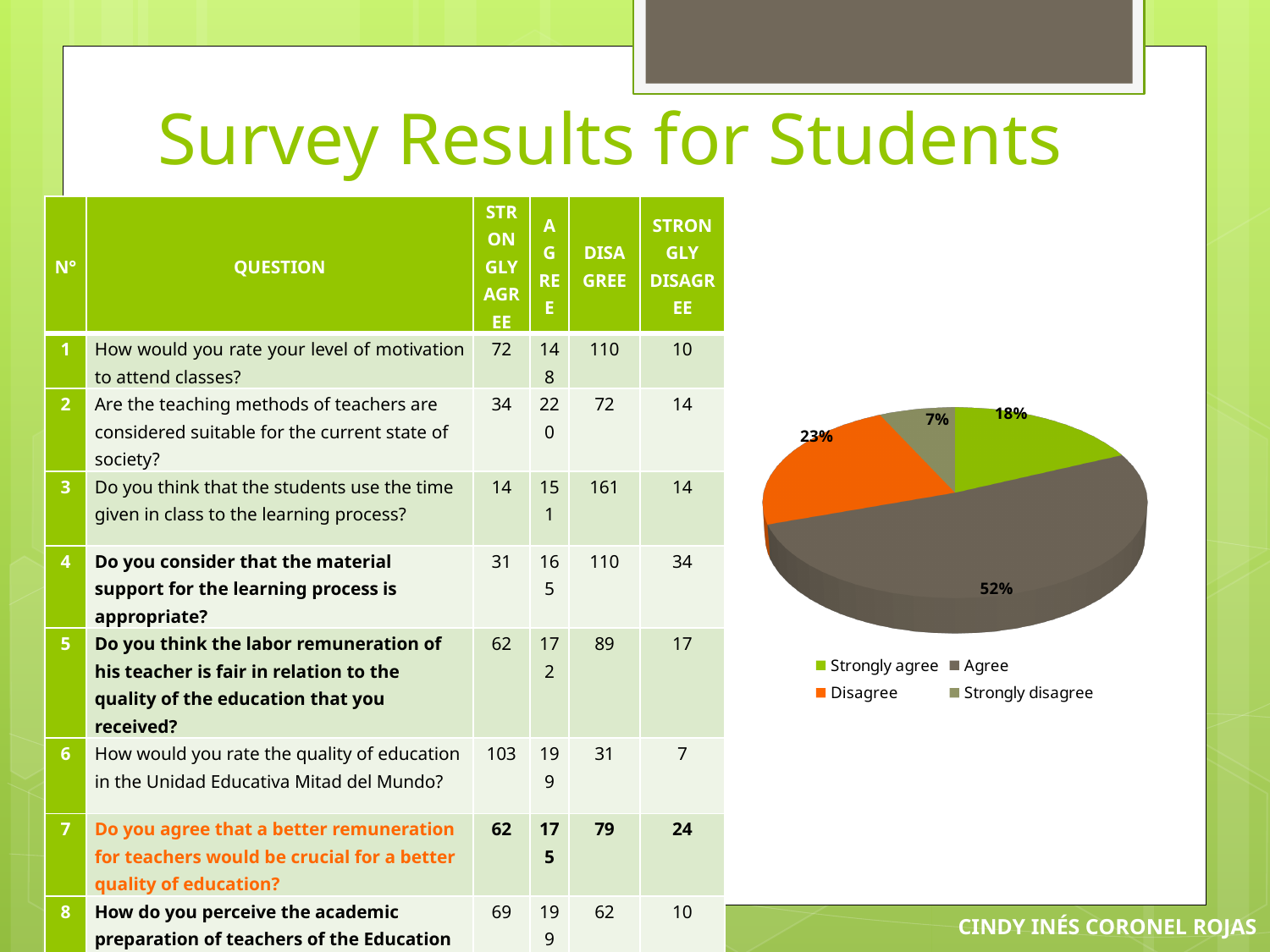
Which category has the largest slice in the pie chart? Agree What percentage does the Strongly agree slice of the pie chart show? 18% How many slices does the pie chart have? 4 What type of chart is shown on the right side of the slide? Pie chart What percentage of the pie chart is labelled for Agree? 52% What percentage does the Disagree slice of the pie chart show? 23% Which colour represents Disagree in the pie chart legend? Orange In the pie chart, which slice is larger: Strongly agree or Disagree? Disagree What is the difference in percentage points between the Agree and Disagree slices of the pie chart? 29 How many entries does the legend of the pie chart list? 4 What percentage does the Strongly disagree slice of the pie chart show? 7% Which category has the smallest slice in the pie chart? Strongly disagree